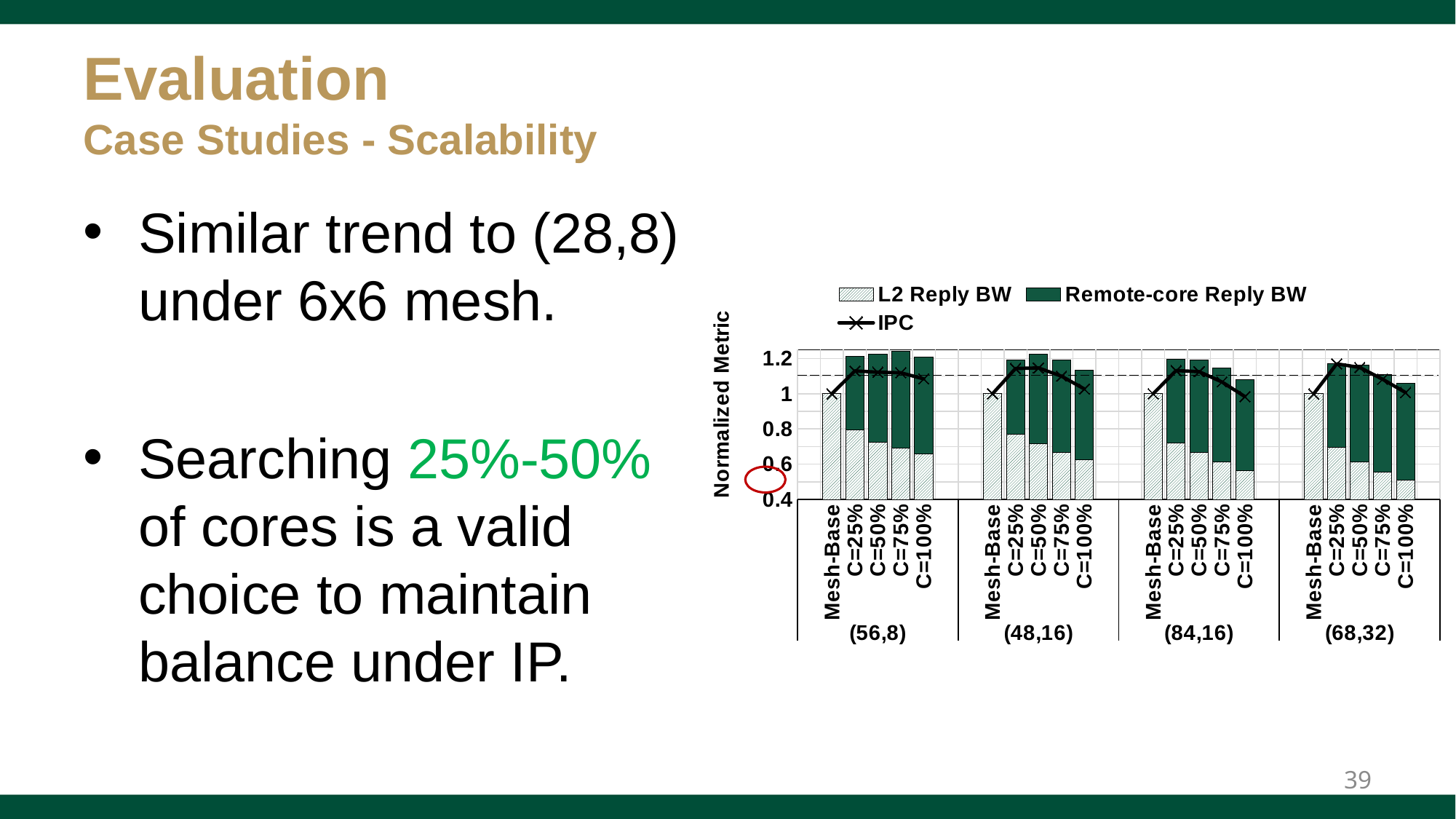
Within the (84,16) group, does the L2 Reply BW rise or fall from Mesh-Base to C=100%? fall Is the L2 Reply BW value for C=100% in the (68,32) group greater or less than 0.6? less Is the L2 Reply BW value for C=100% in the (56,8) group greater or less than 0.6? greater How many bars are plotted in the (56,8) group of the chart? 5 How many configuration groups are shown along the x axis of the chart? 4 Within the (84,16) group, does IPC rise or fall from C=25% to C=100%? fall What are the three series listed in the chart legend? L2 Reply BW, Remote-core Reply BW, IPC What kind of chart is shown on the slide? stacked bar chart with a line What is the label of the chart's vertical axis? Normalized Metric In the (68,32) group, which has the larger L2 Reply BW: Mesh-Base or C=100%? Mesh-Base How many series does the chart legend list? 3 Is the IPC value for C=25% in the (68,32) group greater or less than 1? greater